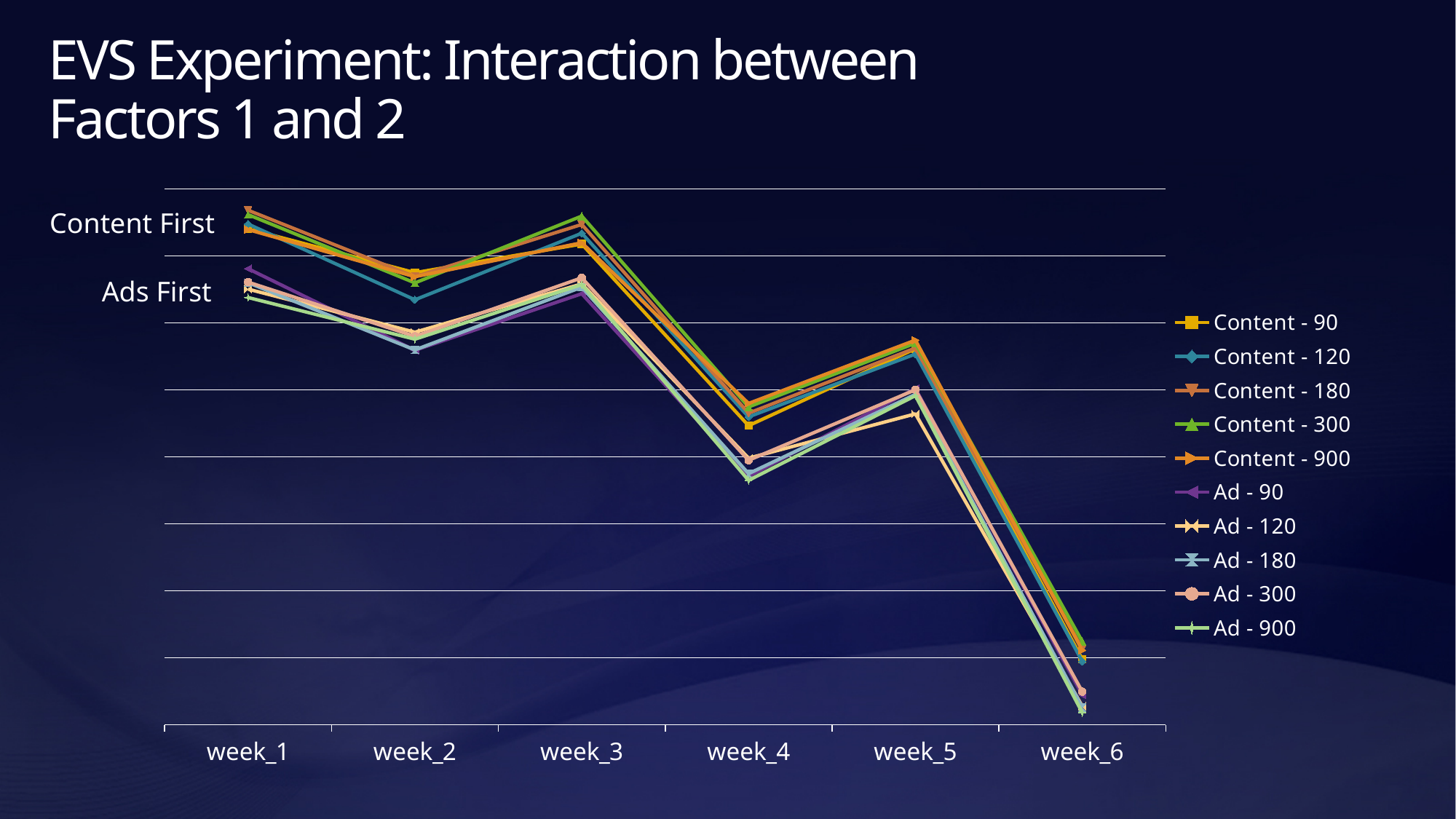
Which is larger for the Content - 120 series: the value in week_1 or the value in week_6? week_1 In which week does the Ad - 900 series reach its lowest value? week_6 Overall, do the values of the Content - 90 series rise or fall from week_1 to week_6? Fall How many weeks are shown along the x axis of the chart? 6 Which is larger in week_4: the value for Content - 90 or the value for Ad - 90? Content - 90 In which week does the Content - 300 series reach its lowest value? week_6 Which two group labels are written to the left of the plotted lines? Content First and Ads First What is the title of the slide containing the chart? EVS Experiment: Interaction between Factors 1 and 2 How many series does the chart's legend list? 10 Between week_4 and week_5, do the values of the Ad - 300 series rise or fall? Rise What kind of chart is shown on the slide? Line chart Which is larger in week_2: the value for Content - 180 or the value for Ad - 180? Content - 180